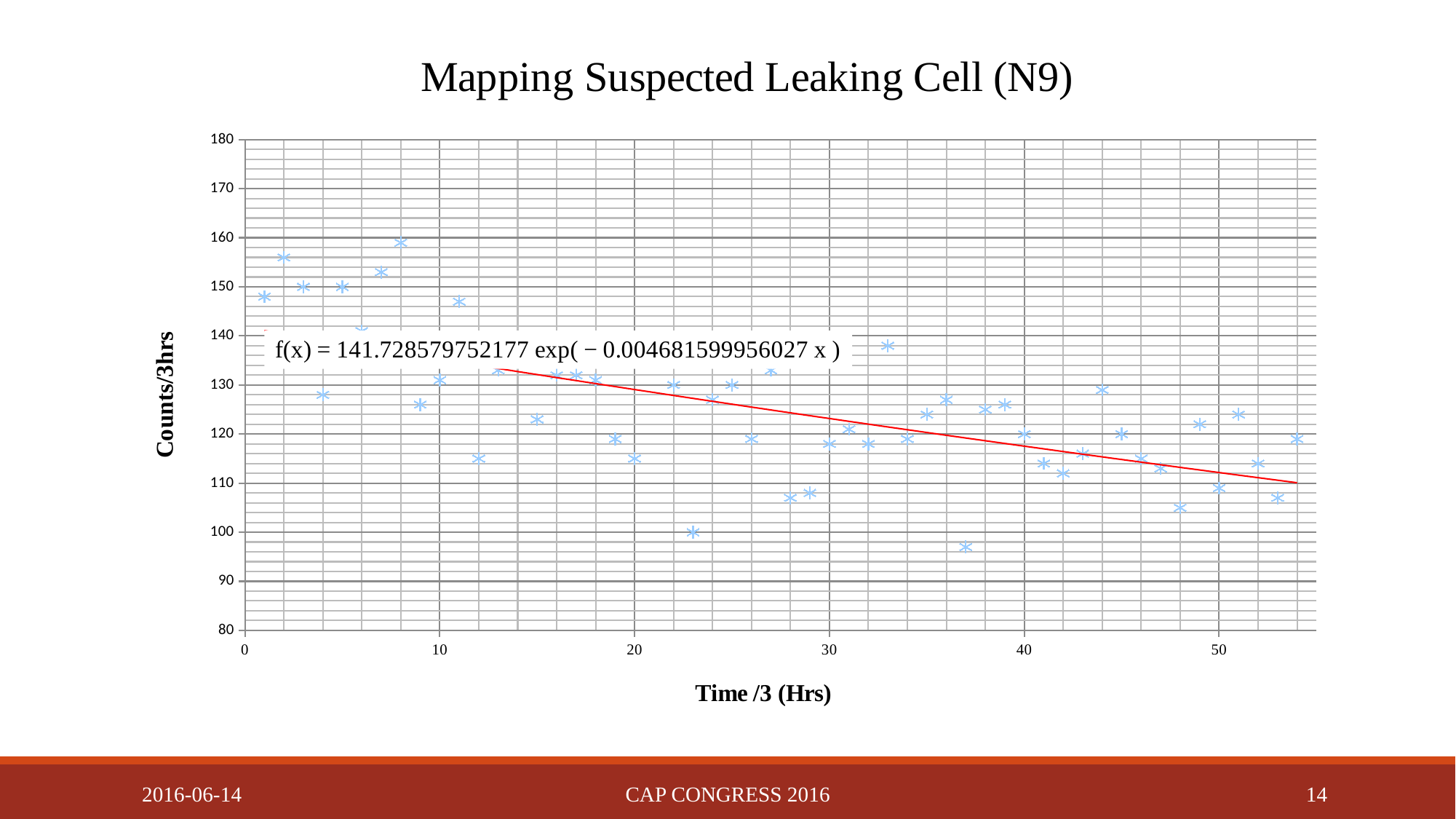
Which has the larger count: the point at time 8 or the point at time 23? the point at time 8 Is the value for the point at time 48 greater or less than 110? less What kind of chart is shown on the slide? scatter chart Which has the larger count: the point at time 37 or the point at time 33? the point at time 33 What is the title of the chart? Mapping Suspected Leaking Cell (N9) Is the value for the point at time 8 greater or less than 150? greater Do the counts generally rise or fall as time increases along the x axis? fall Is the value for the point at time 2 greater or less than 150? greater What fitted function is printed on the chart? f(x) = 141.728579752177 exp( − 0.004681599956027 x )